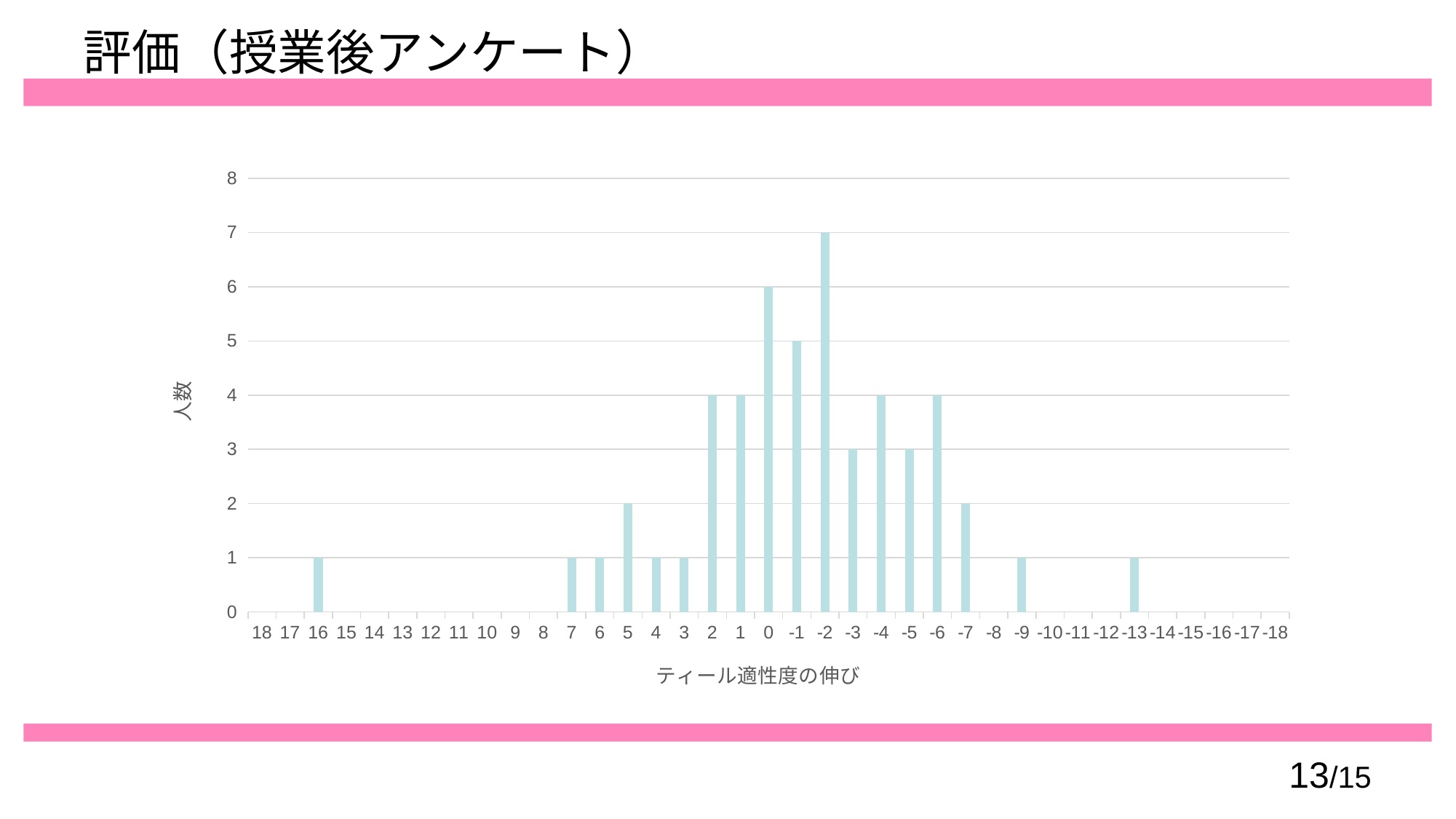
What is the title of the x axis? ティール適性度の伸び What is the 人数 value for the category 16? 1 What is the title of the y axis? 人数 What is the 人数 value for the category -1? 5 How many categories are labelled on the x axis? 37 What is the 人数 value for the category 0? 6 What kind of chart is shown on the slide? bar chart What is the difference between the 人数 values for -2 and 0? 1 What is the 人数 value for the category -2? 7 Which x-axis category has the highest 人数 value? -2 What is the 人数 value for the category -6? 4 Which has a larger 人数 value, category 2 or category -3? 2